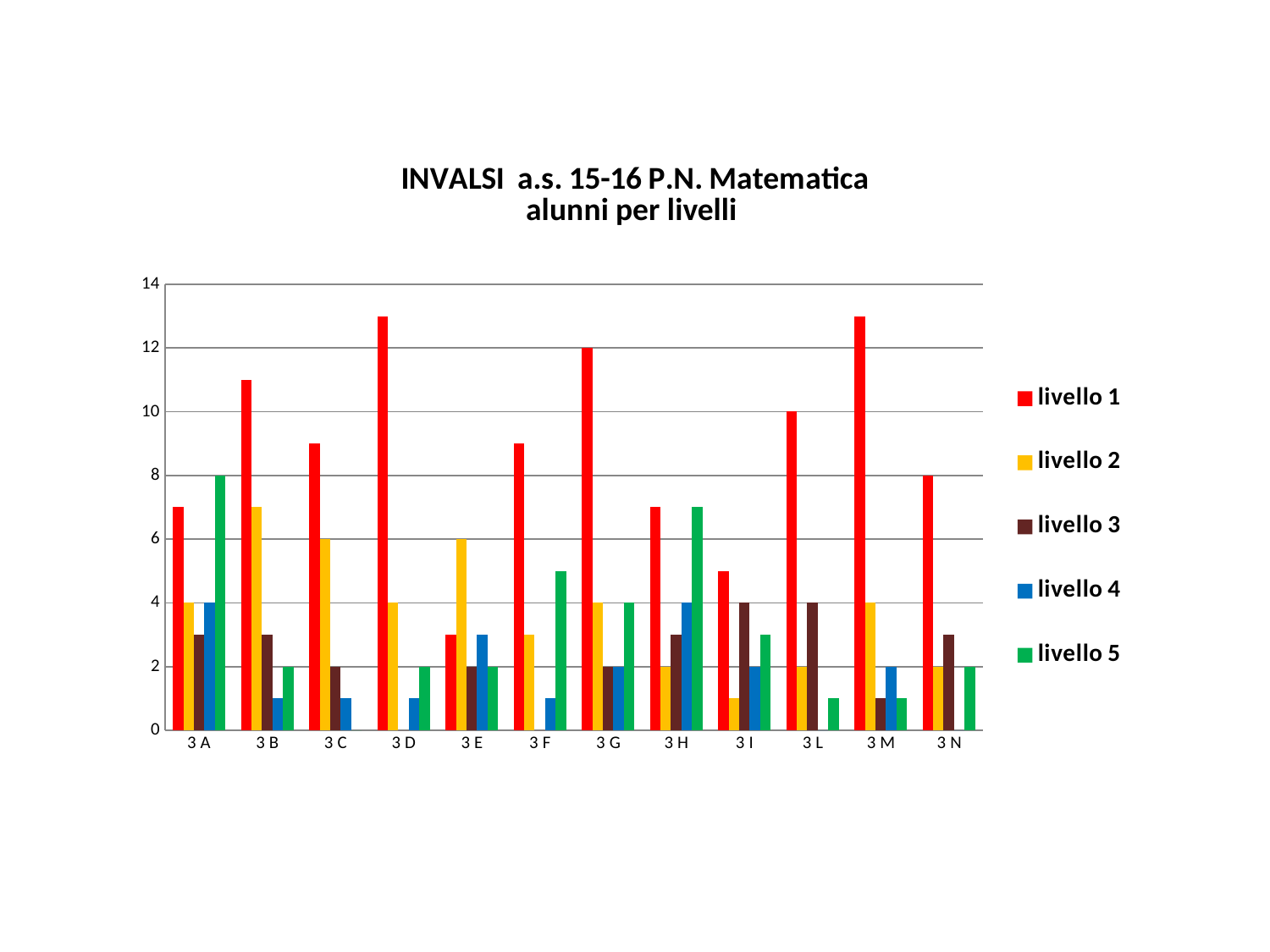
What is the value of livello 2 for class 3 C? 6 What is the value of livello 1 for class 3 L? 10 How many series does the legend list? 5 How many classes are shown on the x axis? 12 Which class has the lowest livello 1 value? 3 E Which is larger, the livello 1 value for 3 G or for 3 L? 3 G Which class has the highest livello 5 value? 3 A Is the livello 1 value for class 3 D greater or less than 12? greater What is the difference between the livello 1 values for 3 G and 3 L? 2 What is the value of livello 5 for class 3 A? 8 What is the value of livello 1 for class 3 G? 12 What kind of chart is shown on the slide? bar chart